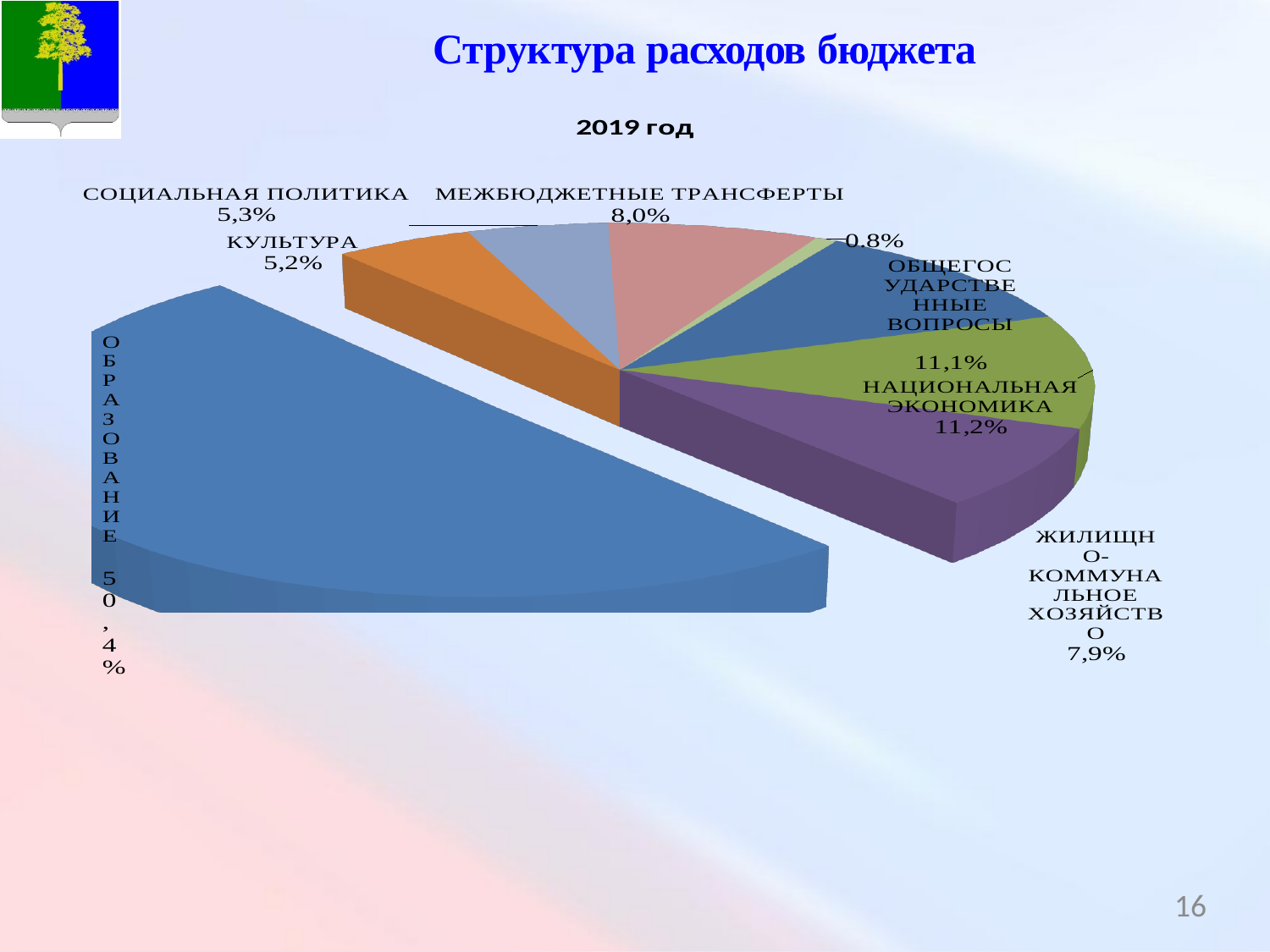
How many slices does the pie chart have? 8 Which category has the largest share of budget expenditure? ОБРАЗОВАНИЕ What is the chart's title? 2019 год What share of budget expenditure goes to НАЦИОНАЛЬНАЯ ЭКОНОМИКА? 11,2% What is the difference in percentage points between the share for ОБЩЕГОСУДАРСТВЕННЫЕ ВОПРОСЫ and the share for ЖИЛИЩНО-КОММУНАЛЬНОЕ ХОЗЯЙСТВО? 3,2 Which is larger: the share for СОЦИАЛЬНАЯ ПОЛИТИКА or the share for КУЛЬТУРА? СОЦИАЛЬНАЯ ПОЛИТИКА What share of budget expenditure goes to ЖИЛИЩНО-КОММУНАЛЬНОЕ ХОЗЯЙСТВО? 7,9% What share of budget expenditure goes to ОБРАЗОВАНИЕ? 50,4% What is the difference in percentage points between the share for ОБРАЗОВАНИЕ and the share for НАЦИОНАЛЬНАЯ ЭКОНОМИКА? 39,2 What share of budget expenditure goes to КУЛЬТУРА? 5,2% What share of budget expenditure goes to МЕЖБЮДЖЕТНЫЕ ТРАНСФЕРТЫ? 8,0% What kind of chart is shown on the slide? pie chart